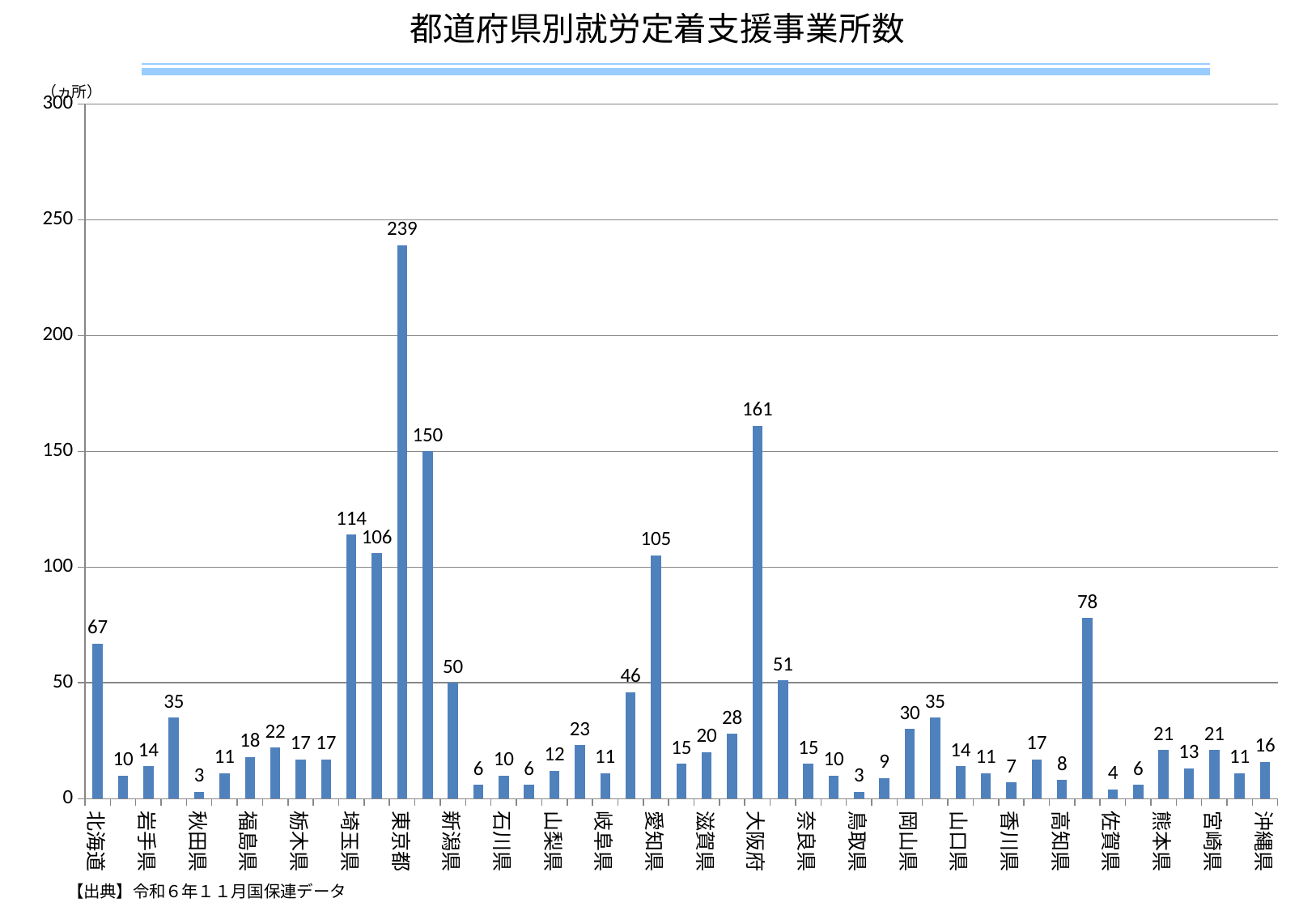
What is the difference between the values for 東京都 and 大阪府? 78 What is the value for 愛知県? 105 Which prefecture has the highest value? 東京都 What type of chart is shown on the slide? bar chart What is the value for 東京都? 239 What is the value for 大阪府? 161 Which is larger, the value for 岡山県 or the value for 滋賀県? 岡山県 What is the title of the chart? 都道府県別就労定着支援事業所数 What is the value for 北海道? 67 Which is larger, the value for 愛知県 or the value for 埼玉県? 埼玉県 What is the difference between the values for 埼玉県 and 新潟県? 64 Is the value for 大阪府 greater or less than 150? greater